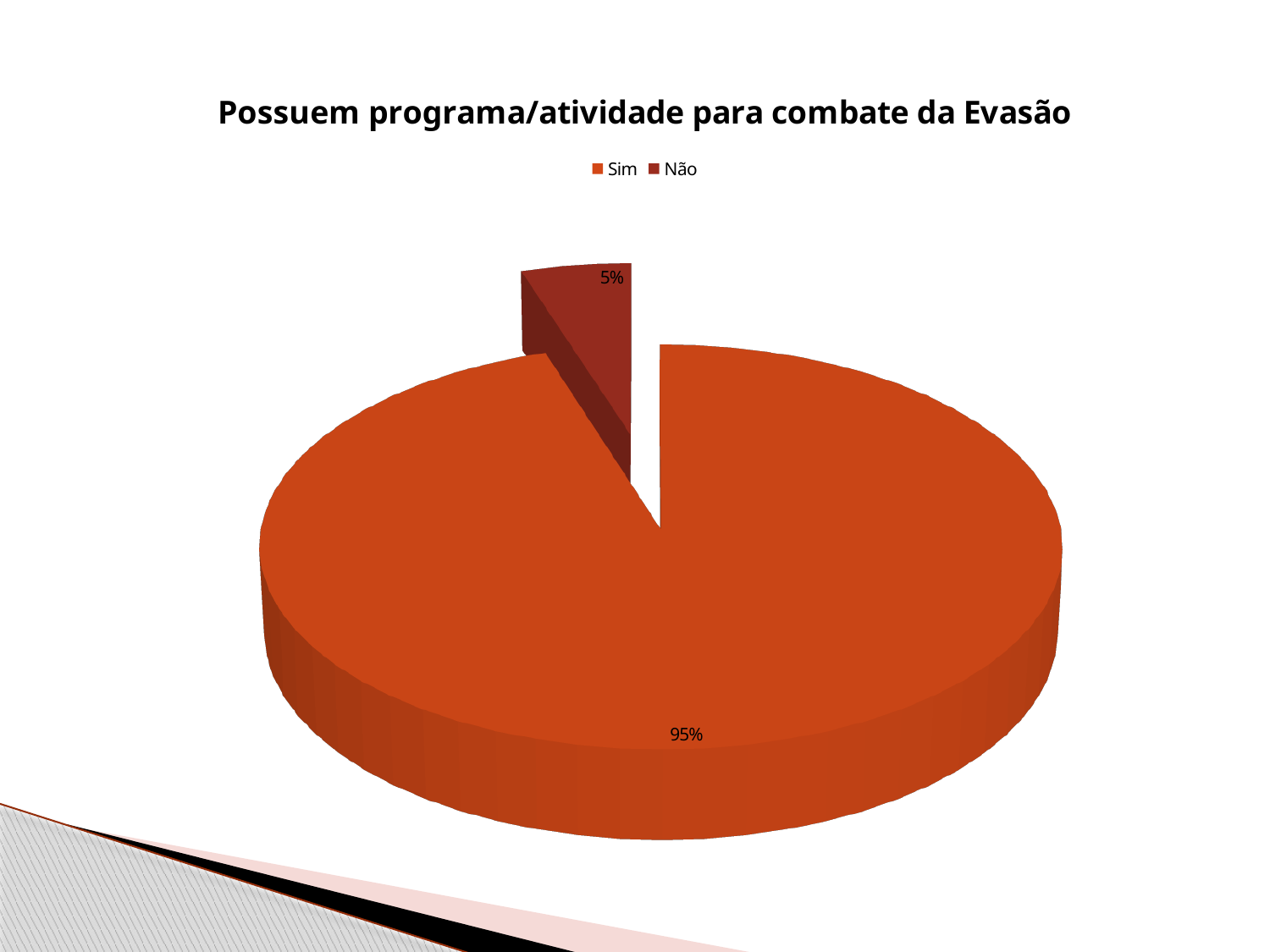
How many slices does the pie chart have? 2 Which legend entry is shown in the darker red colour? Não Which category has the smallest slice? Não How many series does the legend list? 2 What kind of chart is shown on the slide? pie chart What is the title of the chart? Possuem programa/atividade para combate da Evasão What share of the pie does "Sim" represent? 95% Which is larger, the slice for "Sim" or the slice for "Não"? Sim What is the difference in percentage points between "Sim" and "Não"? 90 Which category has the largest slice? Sim What share of the pie does "Não" represent? 5%